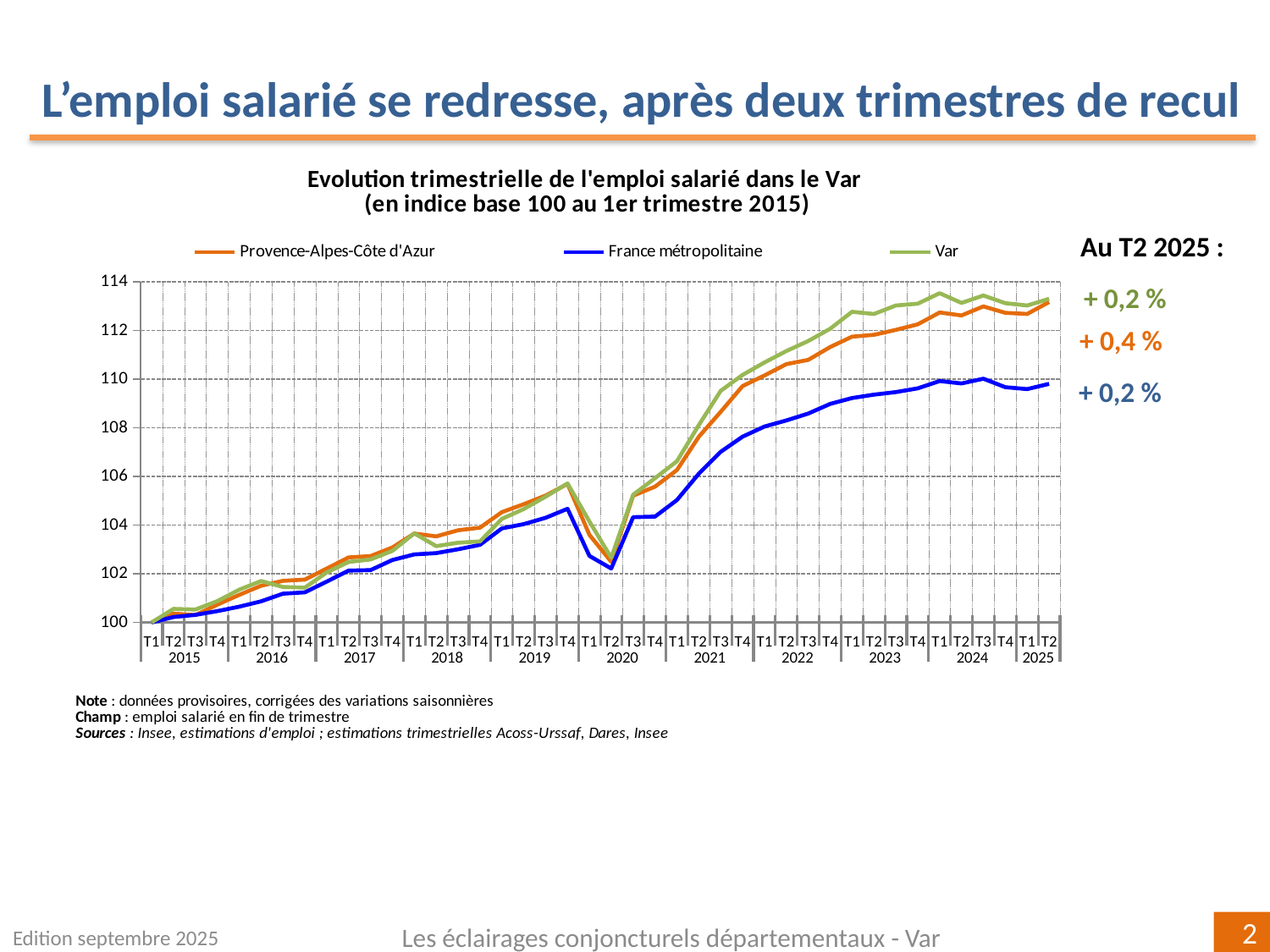
Overall, do the values for Provence-Alpes-Côte d'Azur rise or fall from T1 2015 to T4 2019? rise Do the values for Var rise or fall between T4 2019 and T2 2020? fall Is the value for Var at T2 2025 greater or less than 112? greater Which series has the lowest value at T2 2025? France métropolitaine How many series does the legend list? 3 Is the value for Var at T2 2020 greater or less than 104? less Is the value for France métropolitaine at T2 2025 greater or less than 112? less What kind of chart is shown on the slide? line chart What is the index value of all three series at T1 2015? 100 At T2 2025, which is larger: the value for Var or the value for France métropolitaine? Var How many years are labelled on the x axis? 11 Which series are listed in the legend? Provence-Alpes-Côte d'Azur, France métropolitaine, Var